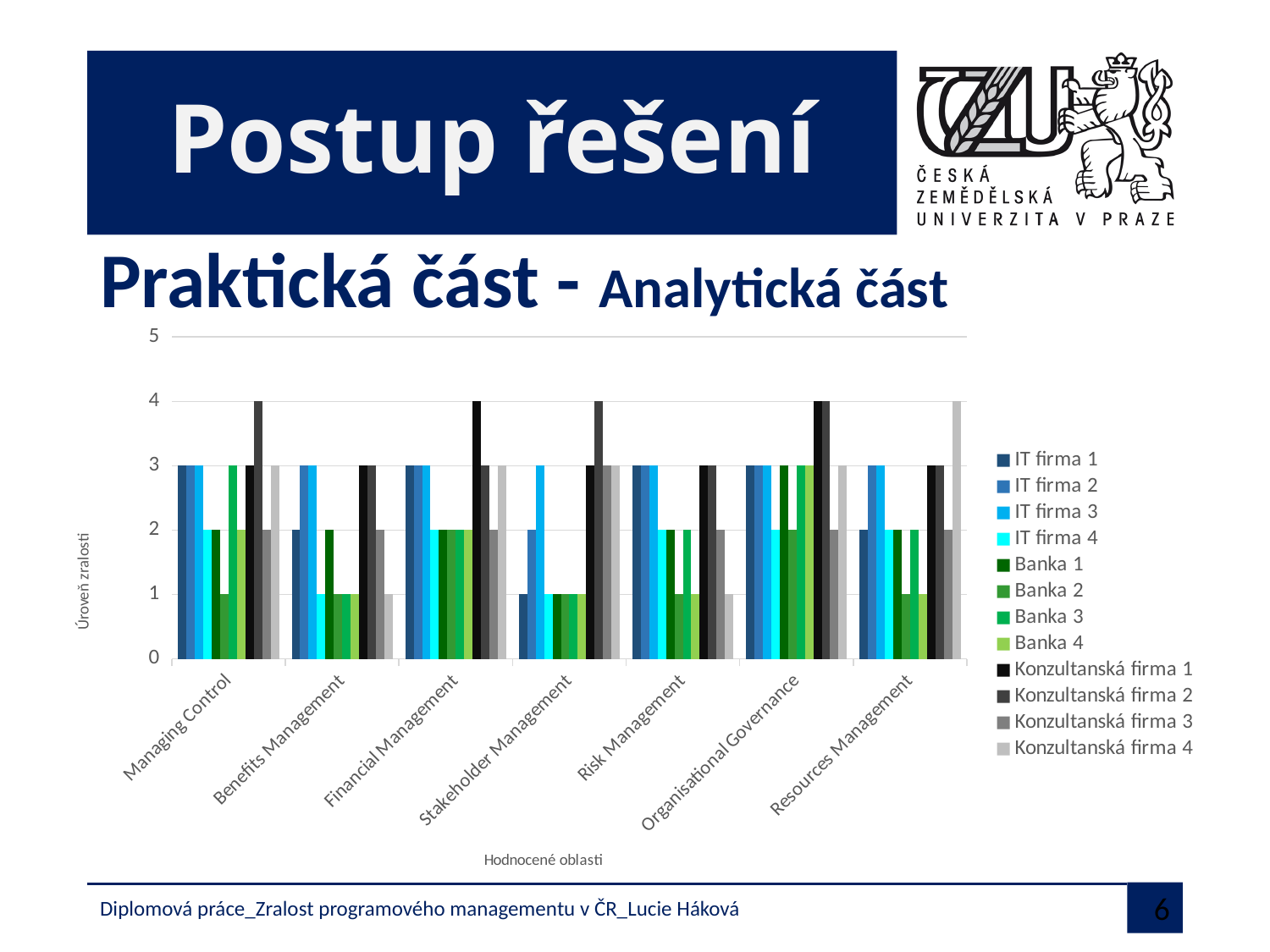
What is the label of the y axis of the chart? Úroveň zralosti Is the value for Konzultanská firma 4 in the Resources Management category greater or less than 3? greater In the Benefits Management category, which is larger: the value for IT firma 2 or the value for IT firma 1? IT firma 2 What is the value for IT firma 3 in the Stakeholder Management category? 3 What is the value for IT firma 4 in the Benefits Management category? 1 How many categories are shown on the x axis of the chart? 7 How many series does the chart legend list? 12 What kind of chart is shown on the slide? bar chart What is the value for Konzultanská firma 4 in the Resources Management category? 4 What is the value for Konzultanská firma 1 in the Financial Management category? 4 What is the label of the x axis of the chart? Hodnocené oblasti What is the value for IT firma 1 in the Stakeholder Management category? 1